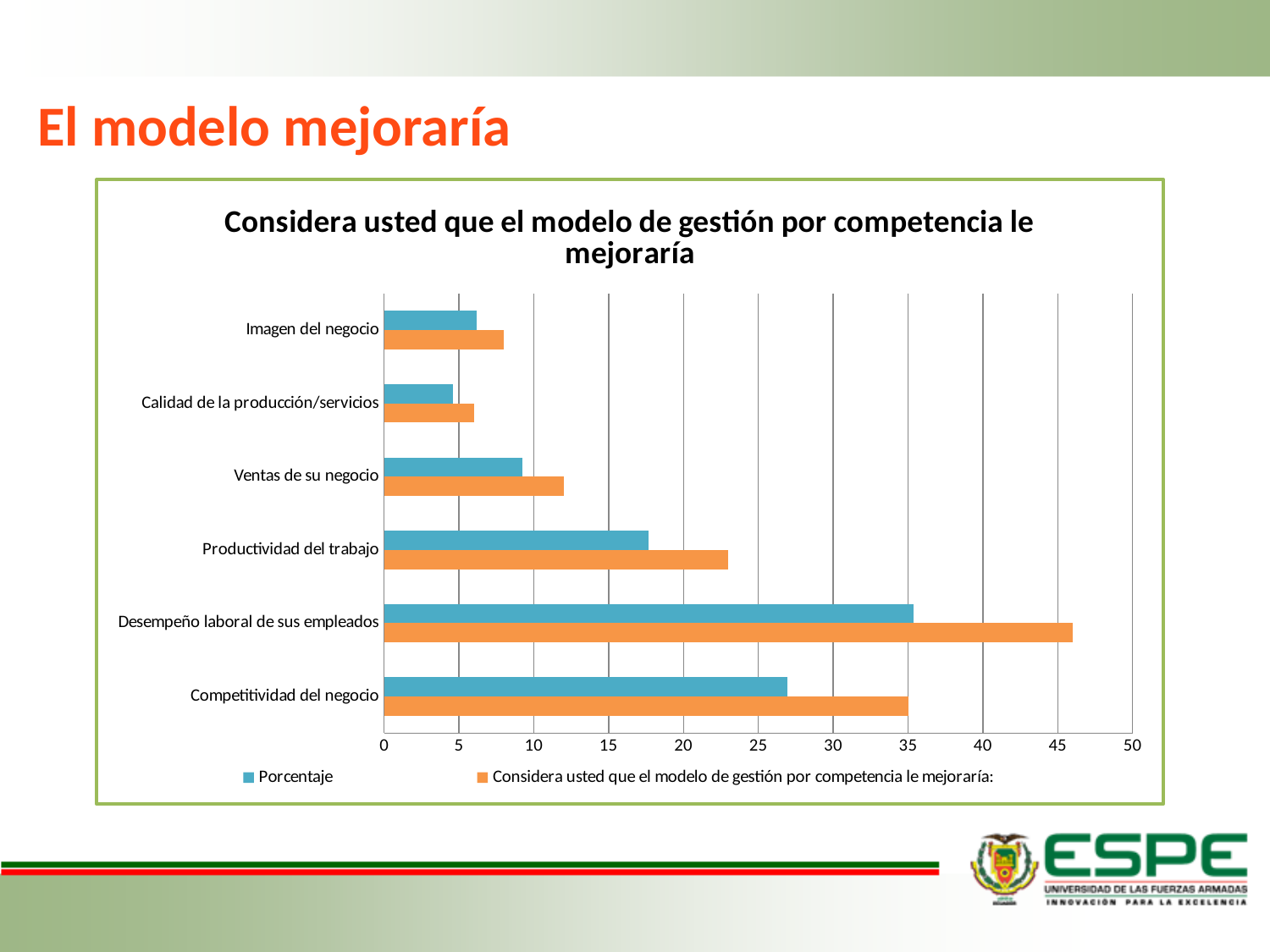
What is the title of the chart? Considera usted que el modelo de gestión por competencia le mejoraría Which category has a larger Porcentaje value: Competitividad del negocio or Productividad del trabajo? Competitividad del negocio How many series does the legend list? 2 Is the value for Ventas de su negocio in the 'Considera usted que el modelo de gestión por competencia le mejoraría:' series greater or less than 10? greater Is the value for Productividad del trabajo in the Porcentaje series greater or less than 20? less Which category has the highest value for the 'Considera usted que el modelo de gestión por competencia le mejoraría:' series? Desempeño laboral de sus empleados How many categories are shown on the chart? 6 What kind of chart is shown on the slide? bar chart Which category has the highest value for the Porcentaje series? Desempeño laboral de sus empleados Which is larger for Competitividad del negocio: the Porcentaje value or the 'Considera usted que el modelo de gestión por competencia le mejoraría:' value? Considera usted que el modelo de gestión por competencia le mejoraría: Is the value for Desempeño laboral de sus empleados in the 'Considera usted que el modelo de gestión por competencia le mejoraría:' series greater or less than 45? greater Which category has the lowest value for the Porcentaje series? Calidad de la producción/servicios